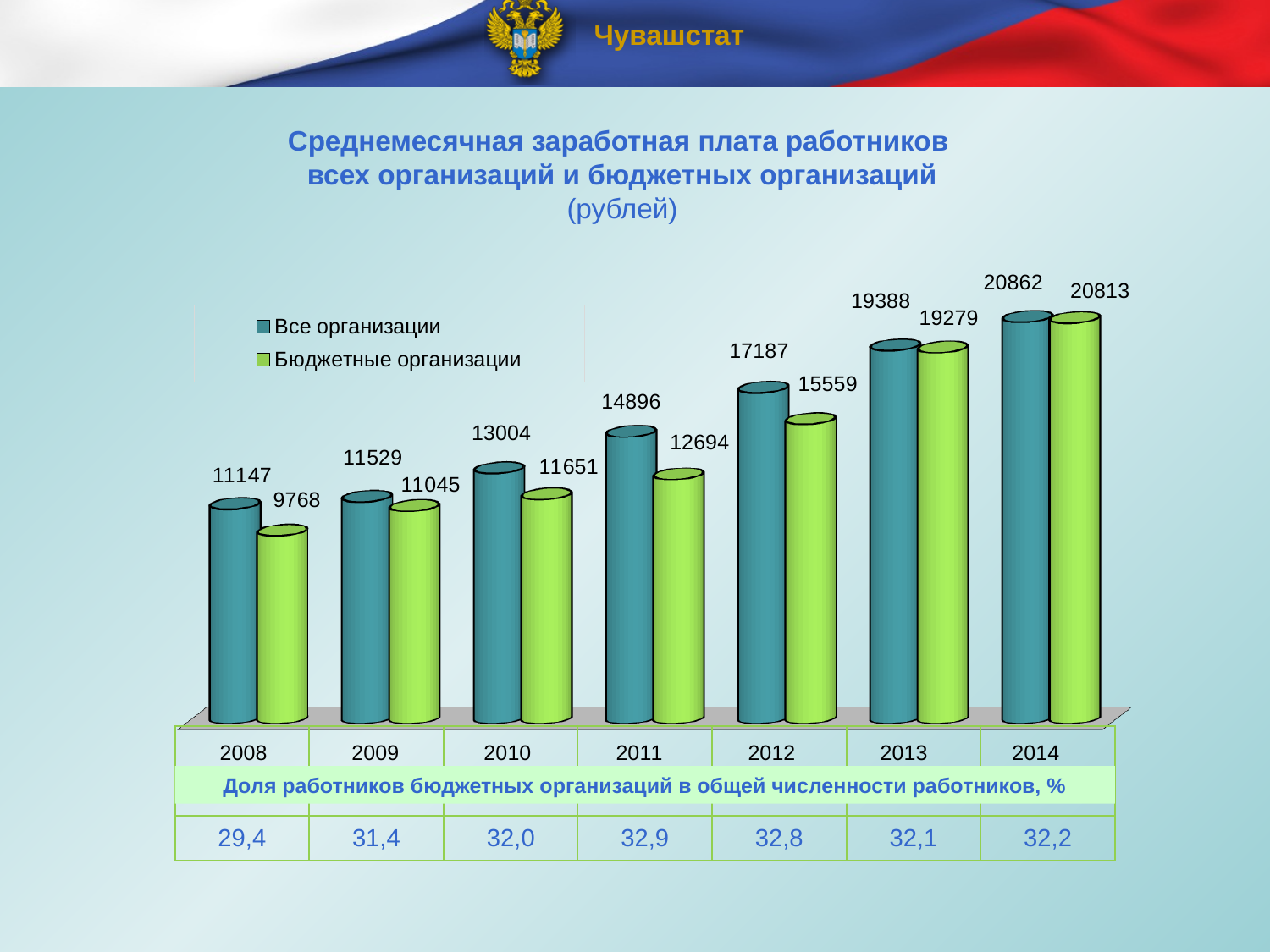
In which year is the value for "Все организации" highest? 2014 How many series does the legend list? 2 What is the difference between "Все организации" and "Бюджетные организации" in 2013? 109 What kind of chart is shown on the slide? Bar chart What is the difference between the "Все организации" values for 2014 and 2008? 9715 What is the value for "Все организации" in 2012? 17187 What is the value for "Бюджетные организации" in 2010? 11651 What is the value for "Бюджетные организации" in 2008? 9768 Do the values for "Бюджетные организации" rise or fall from 2008 to 2014? Rise Which is larger in 2011: the value for "Все организации" or for "Бюджетные организации"? Все организации How many years are shown on the x axis of the chart? 7 In which year is the value for "Бюджетные организации" lowest? 2008